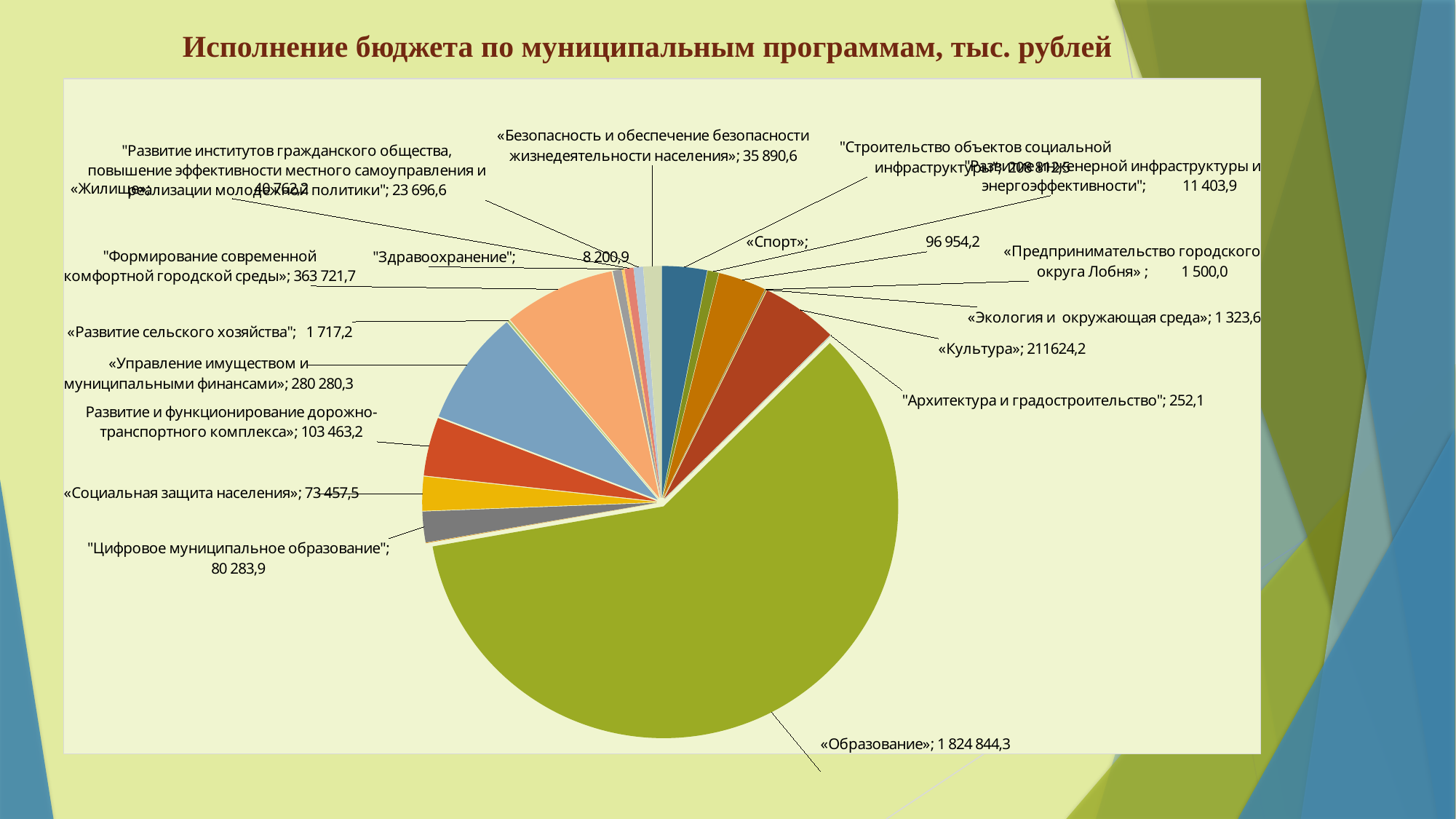
Which program has the smallest value shown on the chart? "Архитектура и градостроительство" What is the value for «Образование»? 1 824 844,3 What is the difference between the values for "Формирование современной комфортной городской среды" and «Управление имуществом и муниципальными финансами»? 83 441,4 Which program has the largest slice of the pie? «Образование» What is the title of the chart on the slide? Исполнение бюджета по муниципальным программам, тыс. рублей What is the value for "Здравоохранение"? 8 200,9 What is the value for "Архитектура и градостроительство"? 252,1 What is the value for «Социальная защита населения»? 73 457,5 Which is larger: the value for «Спорт» or the value for "Цифровое муниципальное образование"? «Спорт» What is the difference between the values for «Спорт» and «Безопасность и обеспечение безопасности жизнедеятельности населения»? 61 063,6 What is the value for «Культура»? 211624,2 What kind of chart is shown on the slide? pie chart